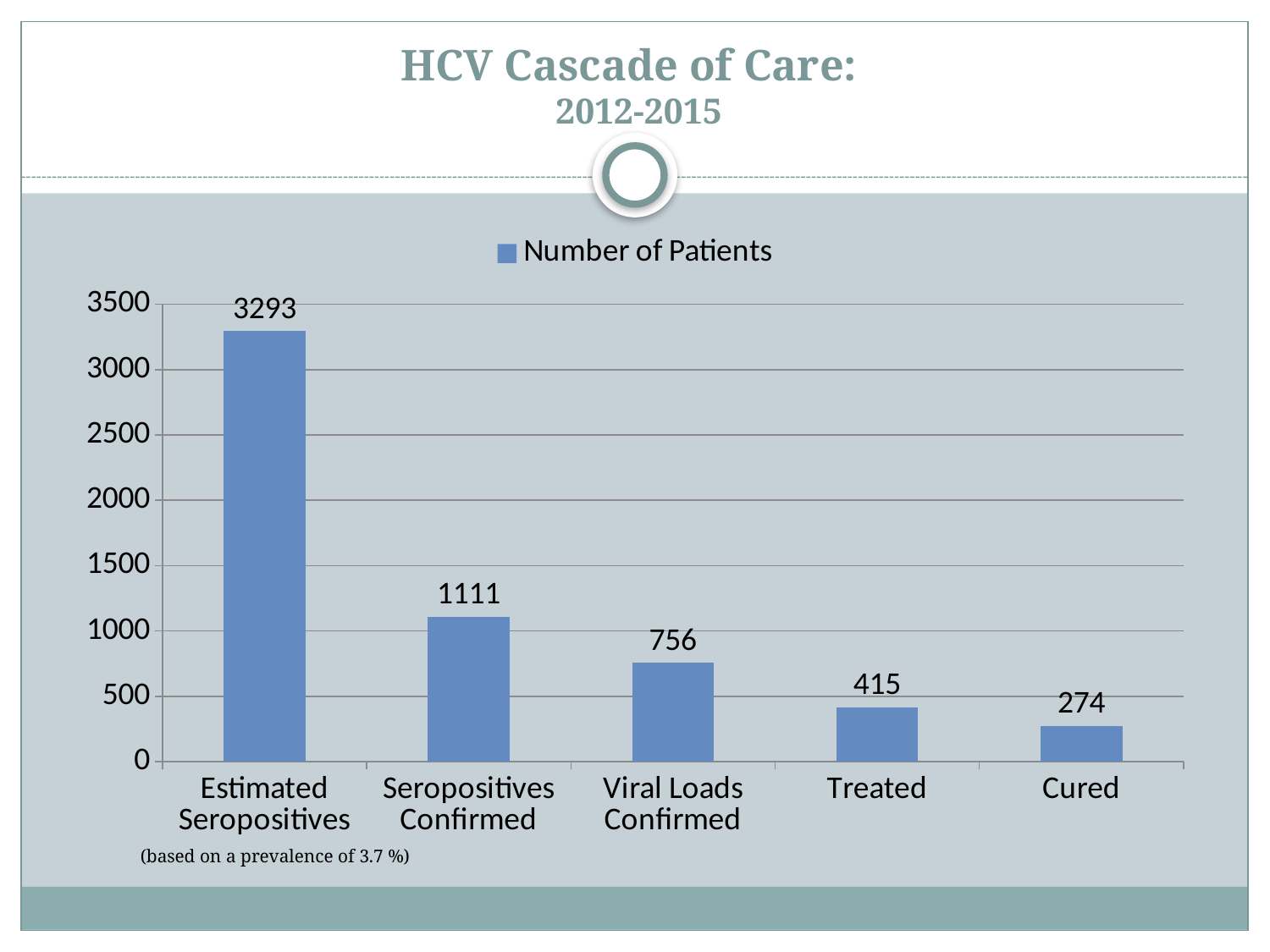
Do the values rise or fall from left to right along the x axis? Fall What is the number of patients Cured? 274 What kind of chart is shown on the slide? Bar chart What is the number of patients for Estimated Seropositives? 3293 What is the number of patients for Seropositives Confirmed? 1111 What is the number of patients for Viral Loads Confirmed? 756 What is the number of patients Treated? 415 Which is larger, the number of Seropositives Confirmed or the number of Viral Loads Confirmed? Seropositives Confirmed Which category has the lowest number of patients? Cured How many categories are shown on the x axis? 5 Which category has the highest number of patients? Estimated Seropositives What is the difference between the number of patients Treated and the number Cured? 141